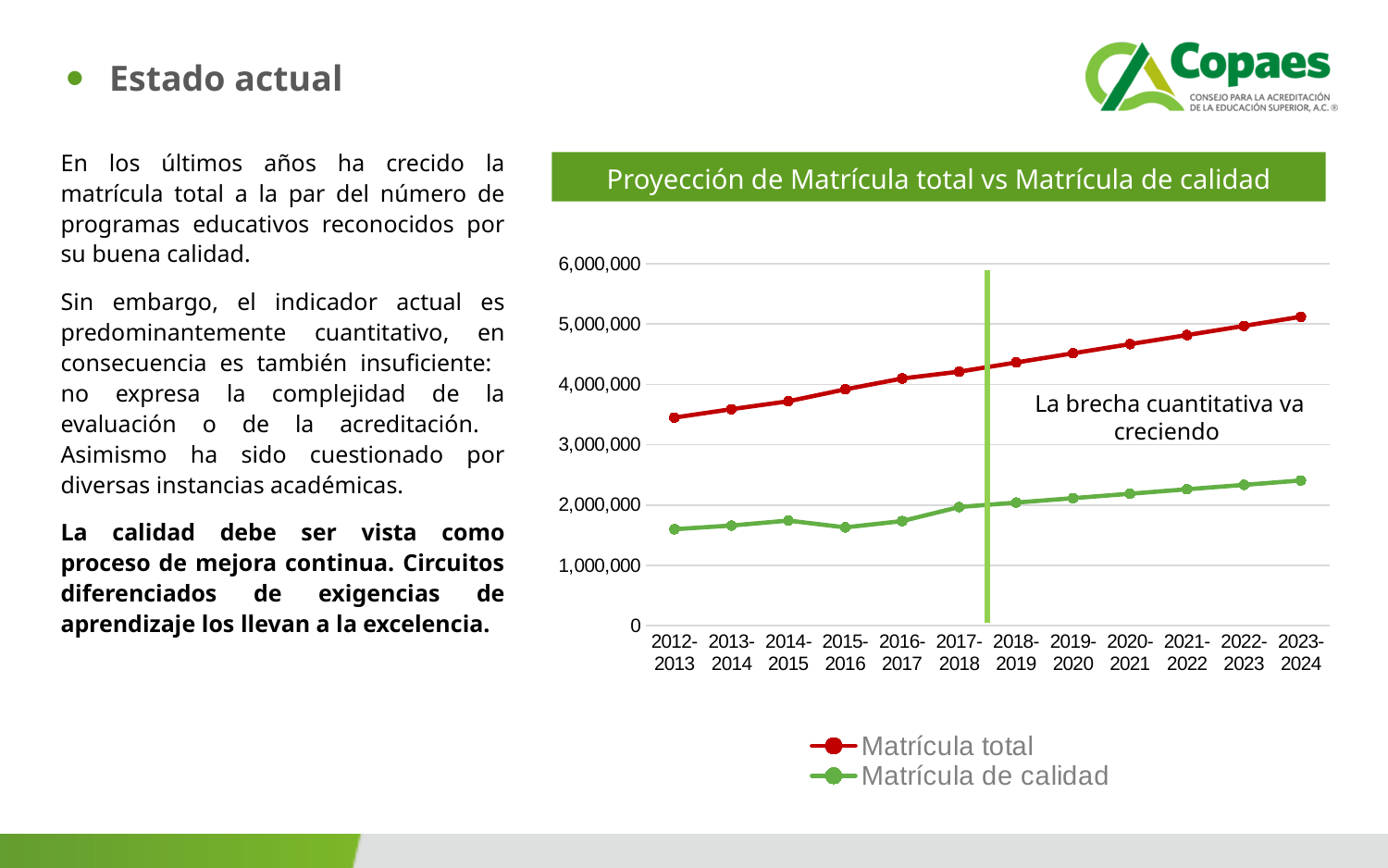
Which is larger in 2023-2024, Matrícula total or Matrícula de calidad? Matrícula total Does Matrícula total rise or fall from 2012-2013 to 2023-2024? Rise In which period does Matrícula total reach its highest value? 2023-2024 How many academic-year periods are shown on the x axis of the chart? 12 What kind of chart is shown on the slide? Line chart Is the value for Matrícula total in 2017-2018 greater or less than 4,000,000? greater Is the value for Matrícula de calidad in 2023-2024 greater or less than 2,000,000? greater What is the title of the chart? Proyección de Matrícula total vs Matrícula de calidad Is the value for Matrícula total in 2012-2013 greater or less than 3,000,000? greater How many series does the chart legend list? 2 Which series is drawn in green in the chart? Matrícula de calidad